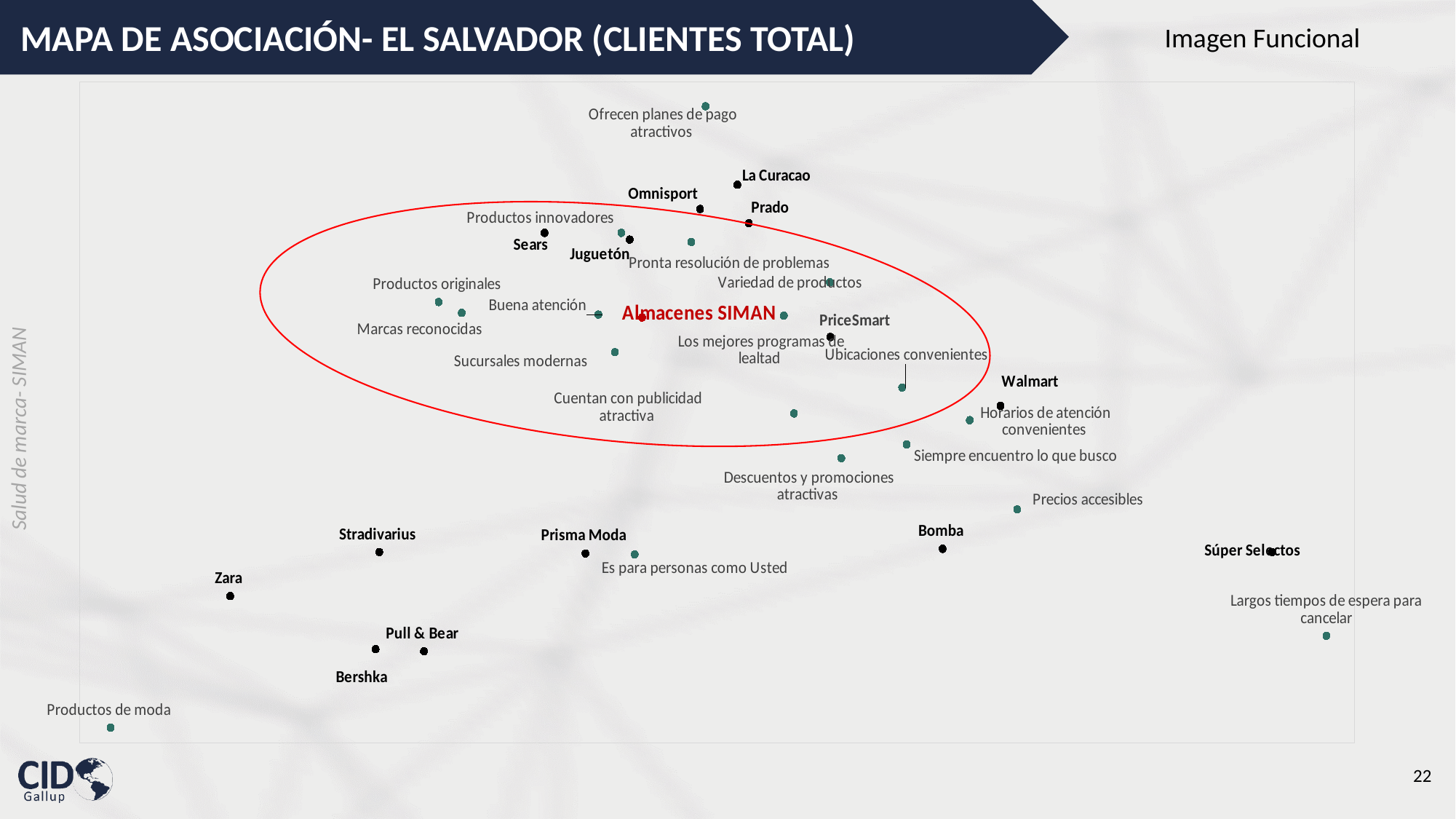
Which attribute is plotted highest (topmost) on the map? Ofrecen planes de pago atractivos Which attribute is plotted lowest (bottommost) on the map? Productos de moda What is the title of the chart on the slide? MAPA DE ASOCIACIÓN- EL SALVADOR (CLIENTES TOTAL) Which brand is plotted furthest to the right on the map? Súper Selectos Which brand is plotted highest (topmost) on the map? La Curacao Which brand is highlighted in red on the association map? Almacenes SIMAN How many brands (black points) are plotted on the association map? 15 What kind of chart is shown on the slide? Scatter plot (association/perceptual map) Which brand is plotted furthest to the left on the map? Zara Which attribute is plotted closest to Prisma Moda on the map? Es para personas como Usted How many attributes (green points) are plotted on the association map? 18